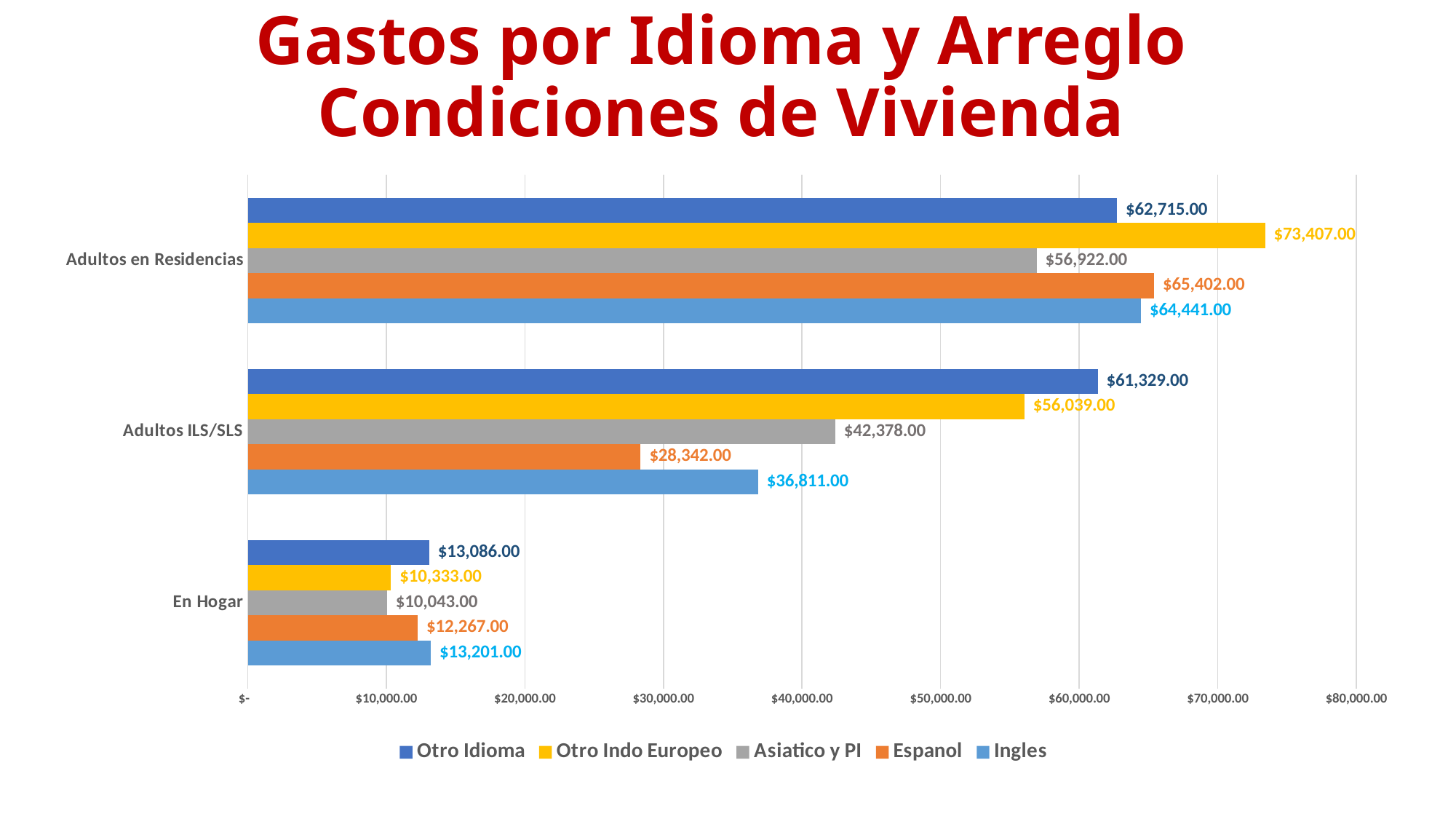
Which series has the highest value in the Adultos en Residencias category? Otro Indo Europeo What is the value for Espanol in the En Hogar category? $12,267.00 In the En Hogar category, which is larger: Otro Idioma or Ingles? Ingles What is the difference between Otro Idioma and Otro Indo Europeo in the Adultos ILS/SLS category? $5,290.00 What is the value for Otro Indo Europeo in the Adultos en Residencias category? $73,407.00 How many series does the legend list? 5 Which series has the lowest value in the Adultos ILS/SLS category? Espanol What is the value for Ingles in the Adultos ILS/SLS category? $36,811.00 What is the difference between Espanol and Ingles in the Adultos en Residencias category? $961.00 How many categories are shown on the vertical axis? 3 What is the title of the slide? Gastos por Idioma y Arreglo Condiciones de Vivienda What kind of chart is shown on the slide? Bar chart